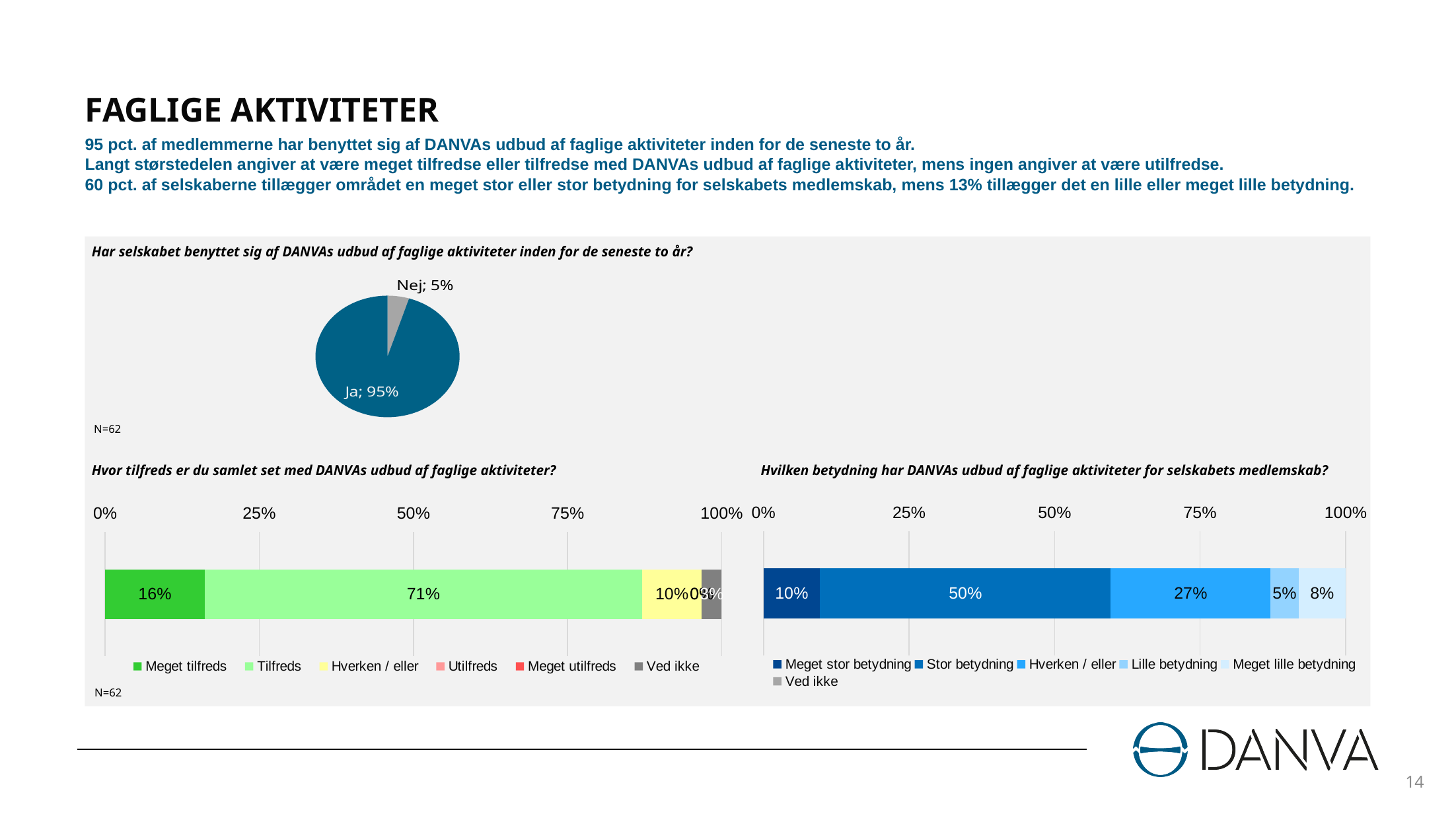
In the chart 'Hvor tilfreds er du samlet set med DANVAs udbud af faglige aktiviteter?', what is the value for 'Meget tilfreds'? 16% In the chart 'Hvilken betydning har DANVAs udbud af faglige aktiviteter for selskabets medlemskab?', how much larger is 'Stor betydning' than 'Meget stor betydning'? 40% In the chart 'Hvor tilfreds er du samlet set med DANVAs udbud af faglige aktiviteter?', what is the value for 'Tilfreds'? 71% In the pie chart at the top of the slide, what share of respondents answered 'Nej'? 5% In the chart 'Hvilken betydning har DANVAs udbud af faglige aktiviteter for selskabets medlemskab?', what is the value for 'Hverken / eller'? 27% How many entries does the legend of the chart 'Hvor tilfreds er du samlet set med DANVAs udbud af faglige aktiviteter?' list? 6 What kind of chart is used for the question 'Har selskabet benyttet sig af DANVAs udbud af faglige aktiviteter inden for de seneste to år?' pie chart In the chart 'Hvilken betydning har DANVAs udbud af faglige aktiviteter for selskabets medlemskab?', which is larger: 'Lille betydning' or 'Meget lille betydning'? Meget lille betydning In the pie chart 'Har selskabet benyttet sig af DANVAs udbud af faglige aktiviteter inden for de seneste to år?', what share of respondents answered 'Ja'? 95% How many slices does the pie chart at the top of the slide have? 2 In the chart 'Hvilken betydning har DANVAs udbud af faglige aktiviteter for selskabets medlemskab?', what is the value for 'Stor betydning'? 50% In the chart 'Hvor tilfreds er du samlet set med DANVAs udbud af faglige aktiviteter?', which category has the largest share? Tilfreds